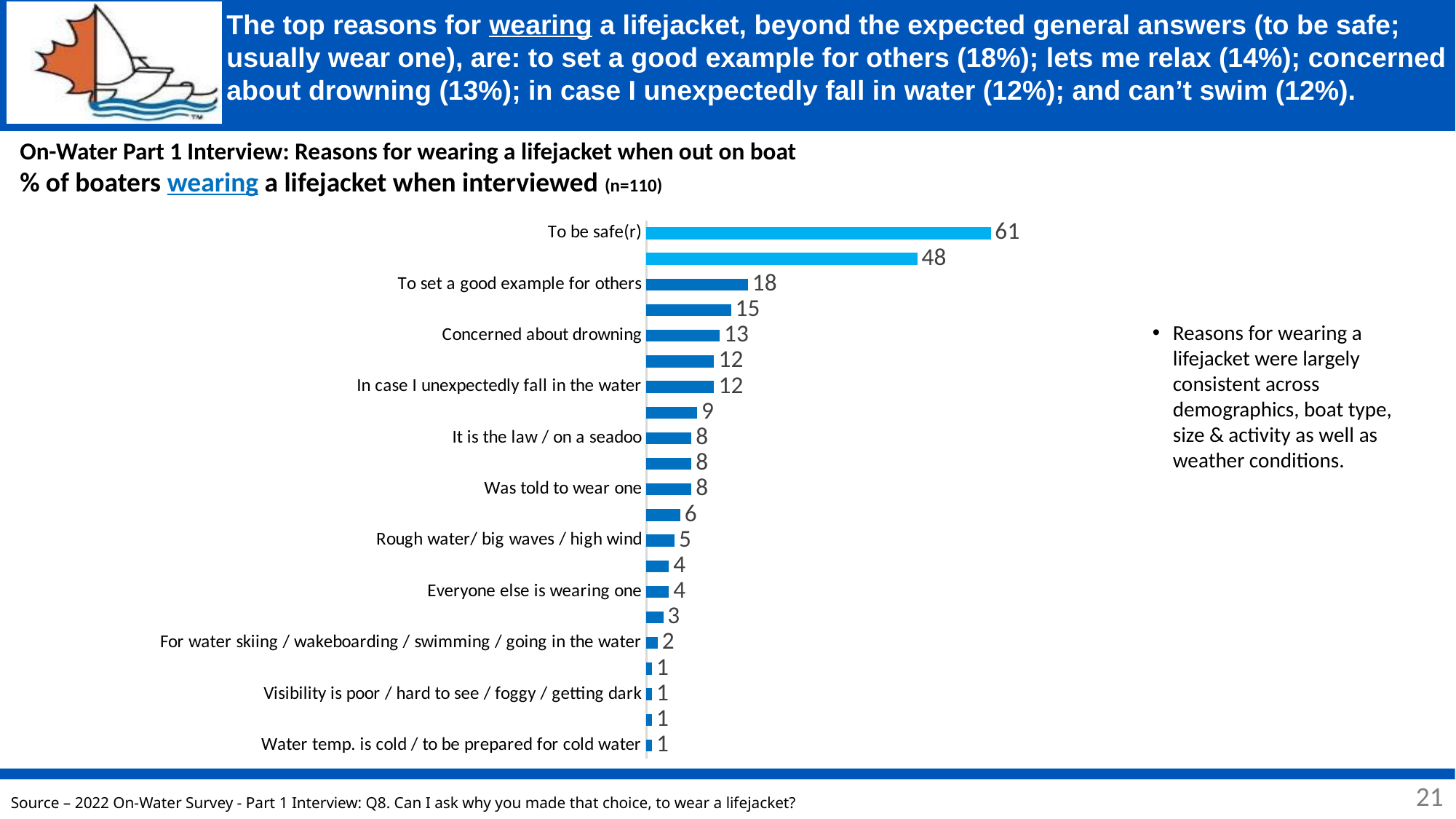
What is the difference between the values for "To be safe(r)" and "To set a good example for others"? 43 What is the value for "To be safe(r)"? 61 What is the value for "In case I unexpectedly fall in the water"? 12 Which labelled reason has the highest value? To be safe(r) What is the value for "Rough water/ big waves / high wind"? 5 What is the value for "Concerned about drowning"? 13 Do the bar values increase or decrease going from the top of the chart to the bottom? Decrease What is the difference between the values for "Concerned about drowning" and "Everyone else is wearing one"? 9 What is the value for "To set a good example for others"? 18 What sample size (n) is stated in the chart title? n=110 Which is larger, the value for "It is the law / on a seadoo" or the value for "Everyone else is wearing one"? It is the law / on a seadoo What kind of chart is shown on the slide? Bar chart